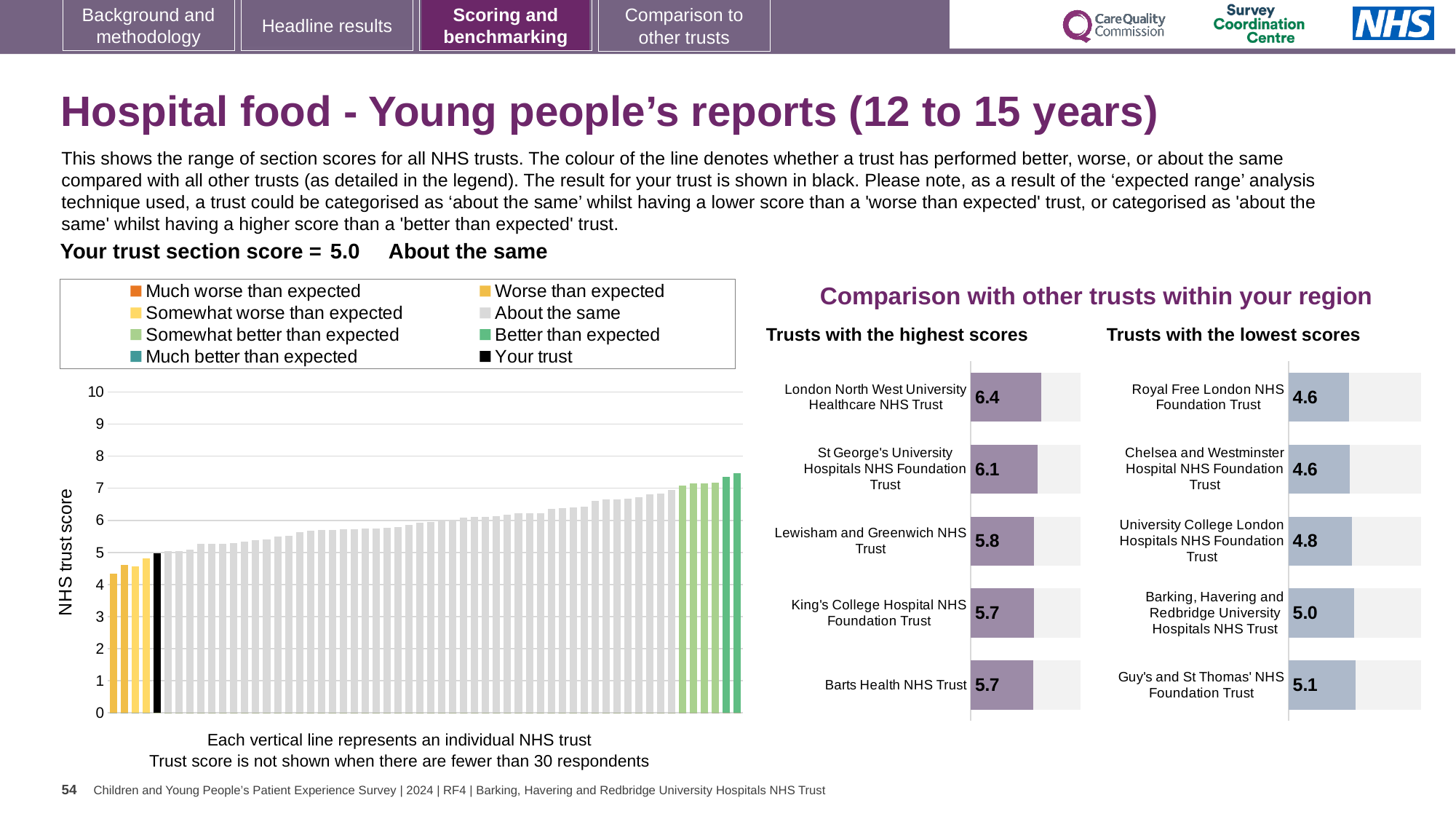
In the NHS trust score chart on the left, is the value of the tallest bar greater or less than 7? greater What kind of chart is the NHS trust score chart on the left of the slide? Bar chart In the 'Trusts with the highest scores' chart, what is the score for London North West University Healthcare NHS Trust? 6.4 In the 'Trusts with the highest scores' chart, which has the larger score: St George's University Hospitals NHS Foundation Trust or King's College Hospital NHS Foundation Trust? St George's University Hospitals NHS Foundation Trust In the NHS trust score chart on the left, do the bars rise or fall from left to right? Rise In the 'Trusts with the highest scores' chart, what is the score for Lewisham and Greenwich NHS Trust? 5.8 In the 'Trusts with the lowest scores' chart, what is the score for Barking, Havering and Redbridge University Hospitals NHS Trust? 5.0 How many trusts are shown in the 'Trusts with the lowest scores' chart? 5 In the 'Trusts with the lowest scores' chart, which trust has the highest score? Guy's and St Thomas' NHS Foundation Trust In the 'Trusts with the lowest scores' chart, what is the difference between the scores of Guy's and St Thomas' NHS Foundation Trust and Royal Free London NHS Foundation Trust? 0.5 In the 'Trusts with the highest scores' chart, what is the difference between the scores of London North West University Healthcare NHS Trust and St George's University Hospitals NHS Foundation Trust? 0.3 How many entries does the legend of the NHS trust score chart on the left list? 8